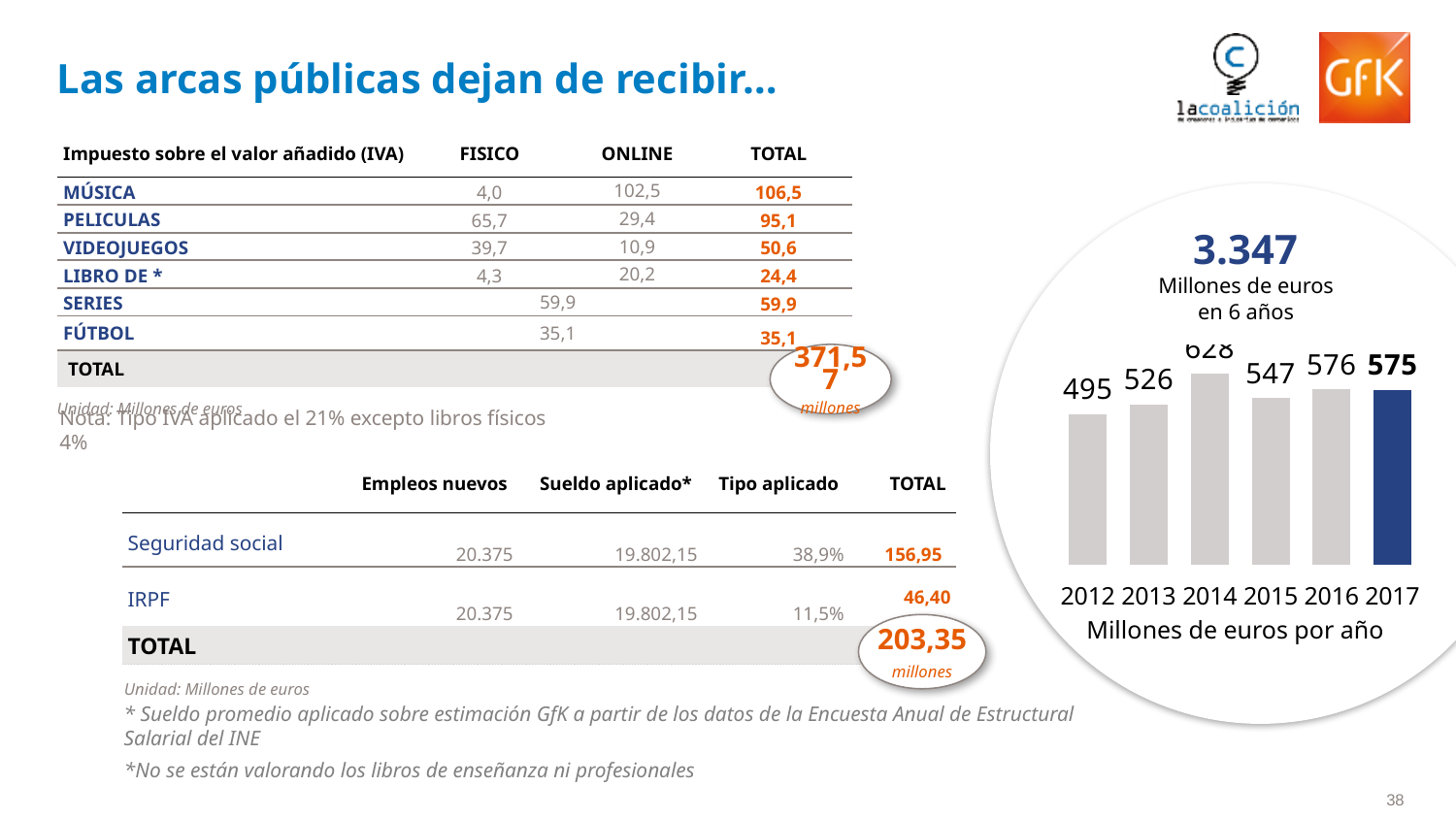
In the bar chart, what is the difference between the values for 2013 and 2012? 31 What is the value for 2012 in the bar chart? 495 How many years are shown on the x axis of the bar chart? 6 In the bar chart, which year has the larger value, 2015 or 2016? 2016 What is the value for 2013 in the bar chart? 526 What is the value for 2015 in the bar chart? 547 What is the value for 2016 in the bar chart? 576 Which year has the lowest value in the bar chart? 2012 Which year has the highest value in the bar chart? 2014 What is the value for 2017 in the bar chart? 575 What kind of chart is shown on the right side of the slide? bar chart Which year's bar is highlighted in blue in the bar chart? 2017